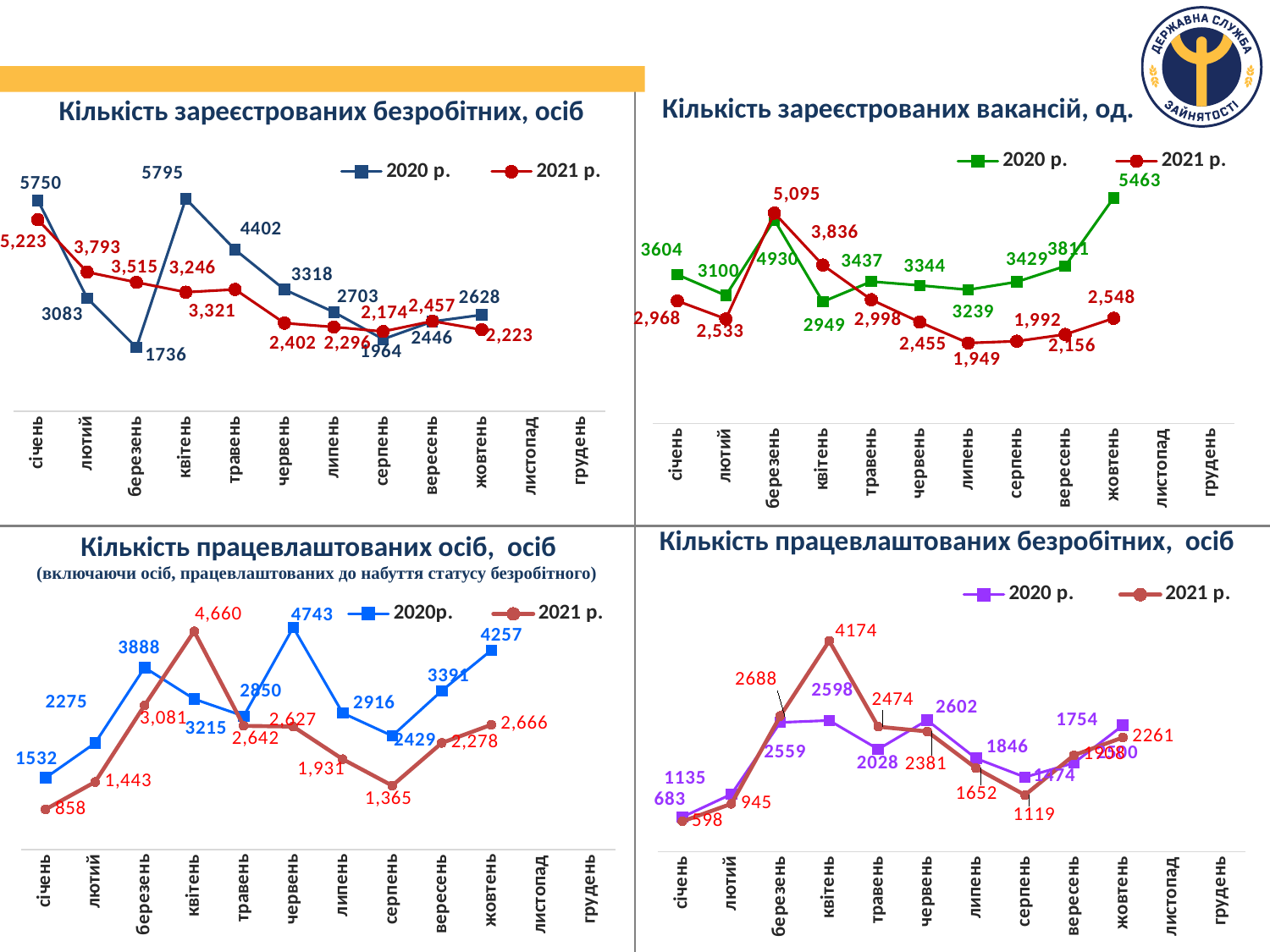
In the chart 'Кількість зареєстрованих вакансій, од.', what is the value for 2021 р. in березень? 5,095 In the chart 'Кількість працевлаштованих безробітних, осіб', which month has the lowest value for 2020 р.? січень In the chart 'Кількість зареєстрованих безробітних, осіб', what is the value for 2020 р. in квітень? 5795 In the chart 'Кількість працевлаштованих осіб, осіб', what is the value for 2021 р. in квітень? 4,660 In the chart 'Кількість працевлаштованих осіб, осіб', how many series does the legend list? 2 In the chart 'Кількість зареєстрованих безробітних, осіб', what is the difference between the 2020 р. and 2021 р. values in січень? 527 In the chart 'Кількість працевлаштованих осіб, осіб', which month has the highest value for 2020р.? червень In the chart 'Кількість зареєстрованих безробітних, осіб', which month has the lowest value for 2020 р.? березень In the chart 'Кількість працевлаштованих безробітних, осіб', what is the value for 2021 р. in квітень? 4174 In the chart 'Кількість зареєстрованих вакансій, од.', which month has the highest value for 2020 р.? жовтень In the chart 'Кількість зареєстрованих вакансій, од.', which is larger in липень: 2020 р. or 2021 р.? 2020 р. What type of chart is 'Кількість зареєстрованих вакансій, од.'? line chart